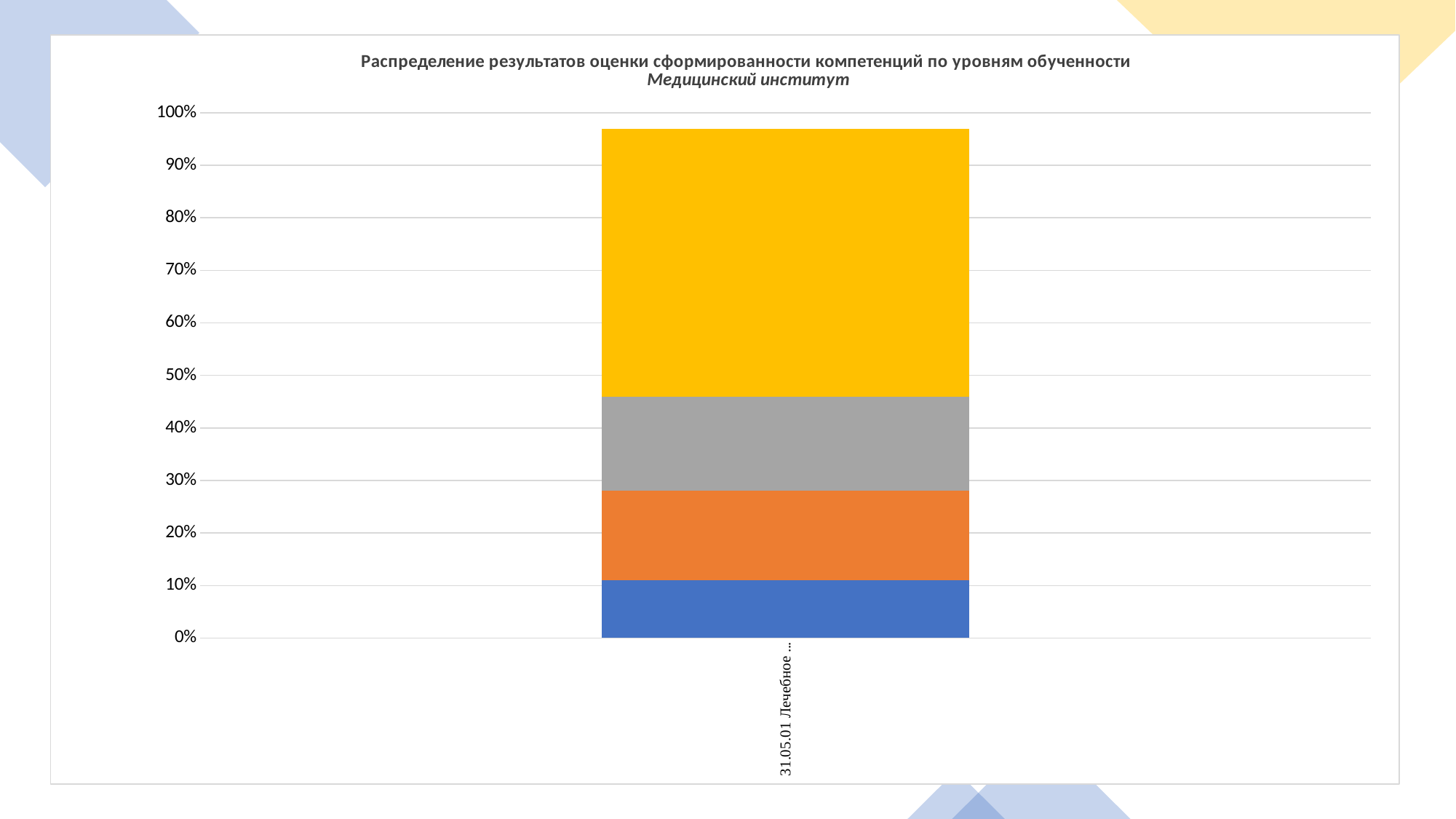
Is the grey segment of the bar for 31.05.01 Лечебное ... greater or less than 30%? less Which coloured segment of the bar for 31.05.01 Лечебное ... is the smallest? blue Is the yellow segment of the bar for 31.05.01 Лечебное ... greater or less than 40%? greater Which segment of the bar for 31.05.01 Лечебное ... is larger, the yellow one or the blue one? yellow Is the orange segment of the bar for 31.05.01 Лечебное ... greater or less than 10%? greater What is the highest value shown on the vertical axis? 100% How many coloured segments make up the stacked bar for 31.05.01 Лечебное ...? 4 What is the title of the chart? Распределение результатов оценки сформированности компетенций по уровням обученности Медицинский институт What kind of chart is shown on the slide? bar chart How many categories are shown on the x axis of the chart? 1